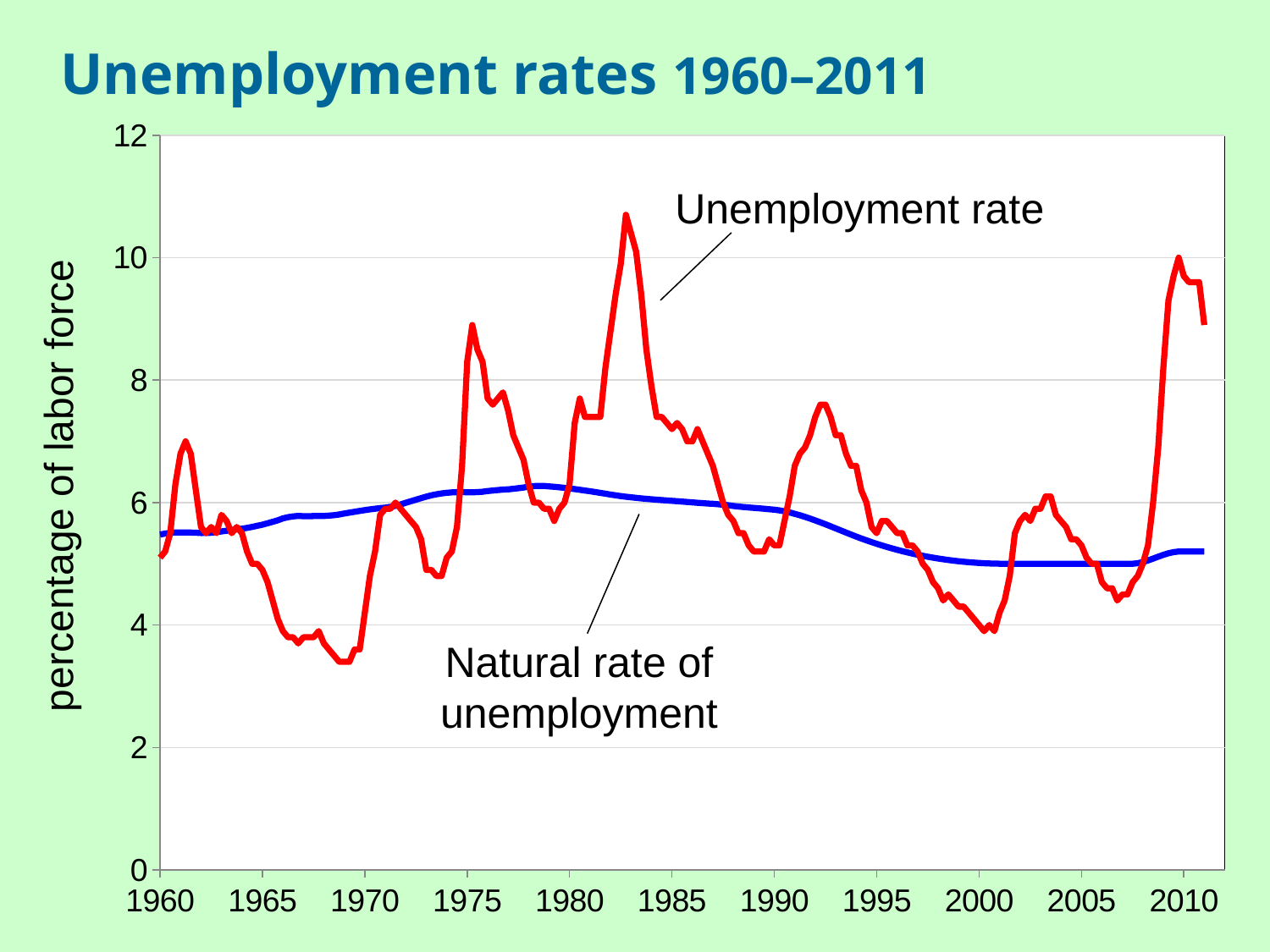
Is the unemployment rate at its peak around 1983 greater or less than 10? greater How many series are plotted on the chart? 2 What kind of chart is shown on the slide? line chart Is the unemployment rate around 1969 greater or less than 4? less Which series reaches the highest value on the chart? Unemployment rate In 1968, which is higher: the unemployment rate or the natural rate of unemployment? Natural rate of unemployment Is the unemployment rate in 2010 greater or less than 8? greater In 1983, which is higher: the unemployment rate or the natural rate of unemployment? Unemployment rate What is the label on the vertical axis? percentage of labor force What is the title of the chart? Unemployment rates 1960–2011 Does the natural rate of unemployment rise or fall between 1980 and 2000? fall